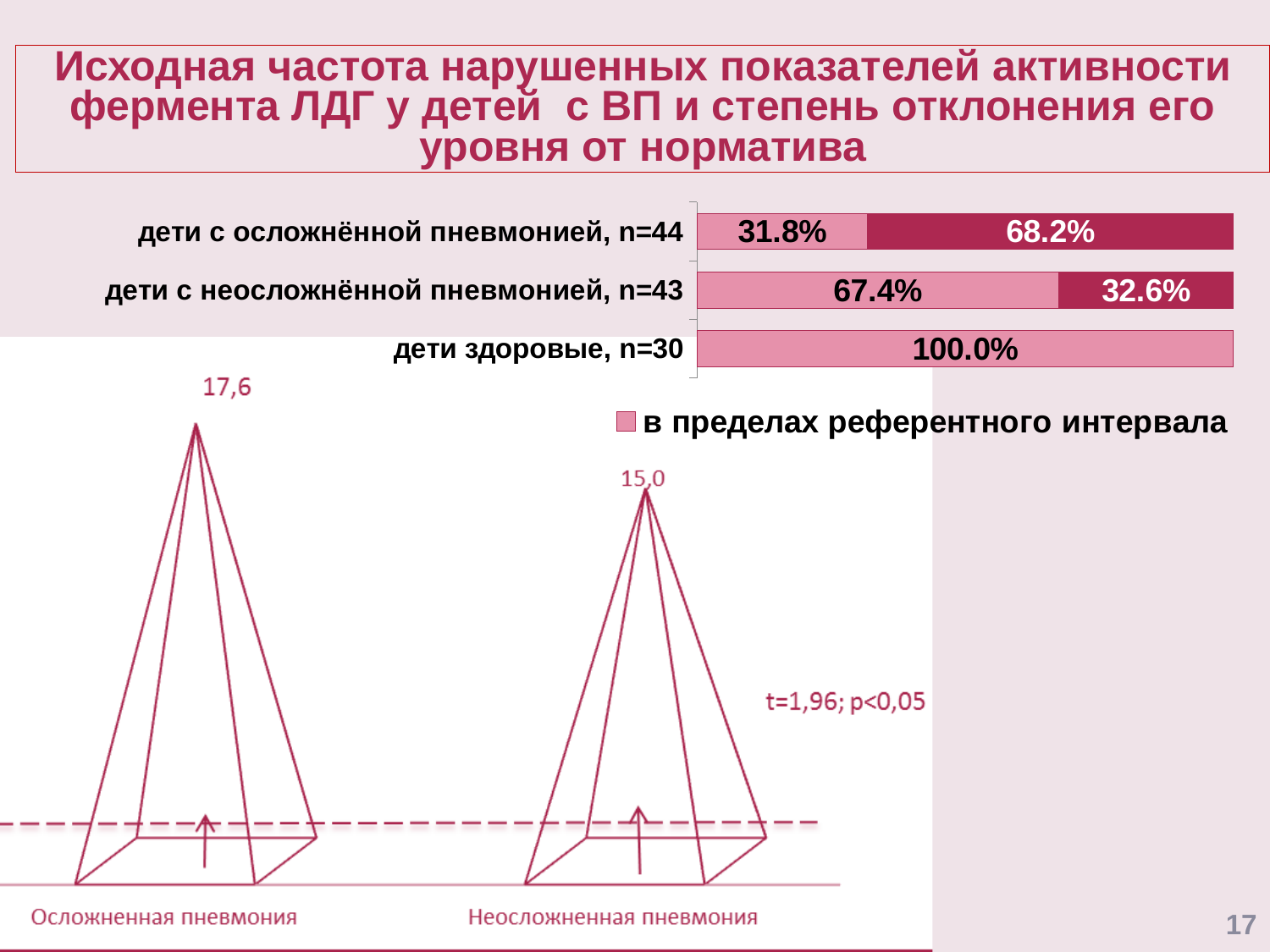
In the bottom pyramid chart, what value is shown for 'Осложненная пневмония'? 17,6 In the top bar chart, which group has the largest light-coloured segment? дети здоровые, n=30 In the top bar chart, which group has the larger light-coloured segment: 'дети с осложнённой пневмонией, n=44' or 'дети с неосложнённой пневмонией, n=43'? дети с неосложнённой пневмонией, n=43 In the top bar chart, what percentage is shown for the dark segment of 'дети с осложнённой пневмонией, n=44'? 68.2% In the top bar chart, what percentage is shown for 'дети здоровые, n=30'? 100.0% In the bottom pyramid chart, what is the difference between the values for 'Осложненная пневмония' and 'Неосложненная пневмония'? 2,6 In the top bar chart, what percentage is shown for the light segment of 'дети с неосложнённой пневмонией, n=43'? 67.4% In the top bar chart, what percentage is shown for the light segment of 'дети с осложнённой пневмонией, n=44'? 31.8% In the top bar chart, what percentage is shown for the dark segment of 'дети с неосложнённой пневмонией, n=43'? 32.6% What kind of chart is the top chart on the slide? Bar chart In the bottom pyramid chart, what value is shown for 'Неосложненная пневмония'? 15,0 How many categories (groups of children) are shown in the top bar chart? 3